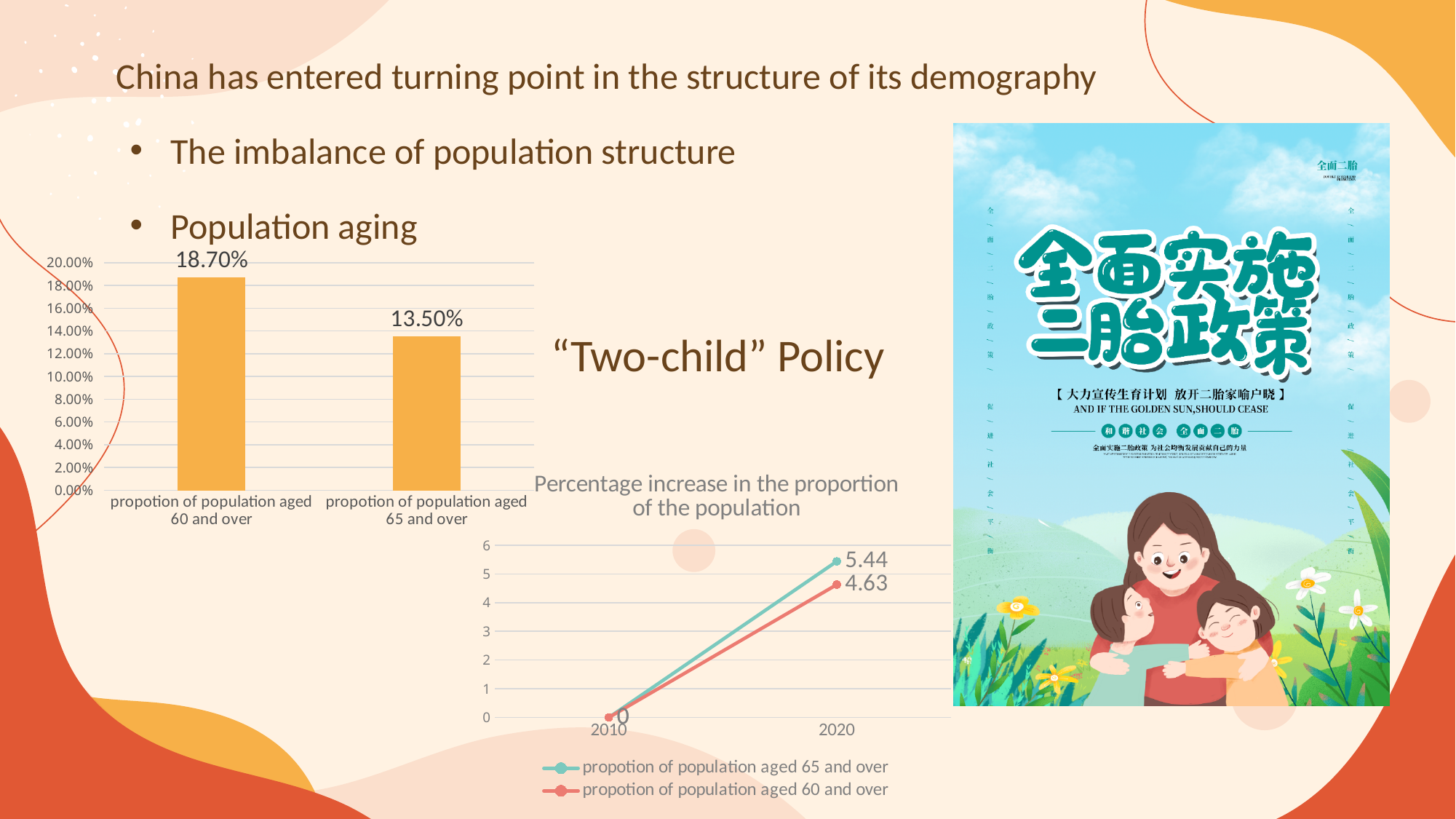
In the chart titled 'Percentage increase in the proportion of the population', how many series does the legend list? 2 In the bar chart on the left, which category has the higher value? propotion of population aged 60 and over In the bar chart on the left, how many bars are plotted? 2 In the chart titled 'Percentage increase in the proportion of the population', what is the 2020 value for the proportion of population aged 60 and over? 4.63 What kind of chart is the chart on the left of the slide? Bar chart In the chart titled 'Percentage increase in the proportion of the population', what is the difference between the two series' 2020 values? 0.81 In the chart titled 'Percentage increase in the proportion of the population', do the values rise or fall from 2010 to 2020? Rise In the bar chart on the left, what is the value for the proportion of population aged 60 and over? 18.70% In the chart titled 'Percentage increase in the proportion of the population', what is the 2020 value for the proportion of population aged 65 and over? 5.44 In the chart titled 'Percentage increase in the proportion of the population', which series has the higher value in 2020? propotion of population aged 65 and over In the bar chart on the left, what is the value for the proportion of population aged 65 and over? 13.50% In the bar chart on the left, what is the difference between the two bars? 5.20%